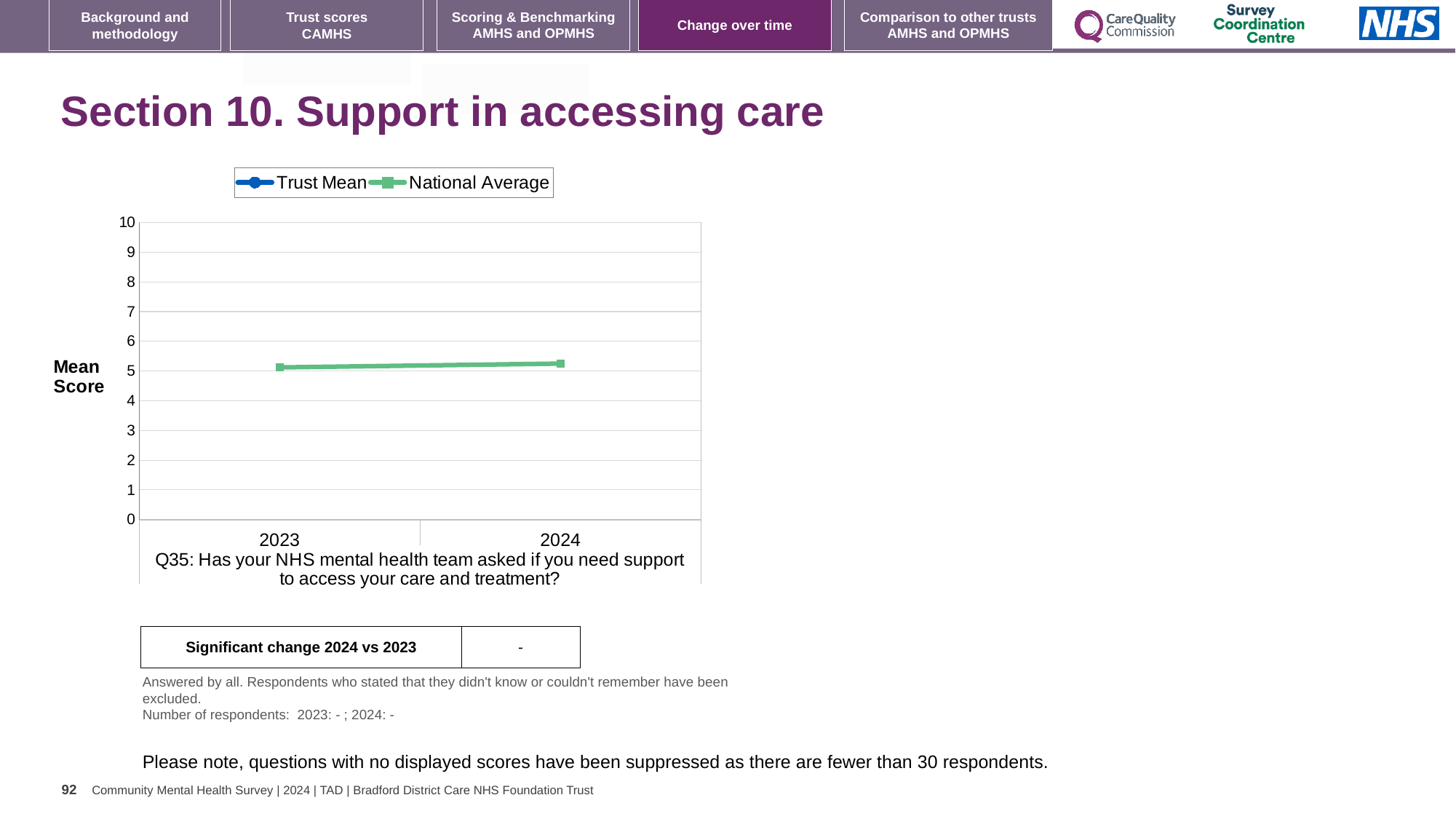
How many years are shown on the x axis of the chart? 2 What is the maximum value shown on the y axis of the chart? 10 Which years are shown on the x axis of the chart? 2023 and 2024 Which series in the legend has no plotted line on the chart? Trust Mean Does the National Average line rise or fall from 2023 to 2024? rise How many series does the chart legend list? 2 What kind of chart is shown on the slide? line chart Is the National Average value for 2024 greater or less than 7? less Is the National Average value for 2023 greater or less than 4? greater Is the National Average value for 2024 greater or less than 6? less